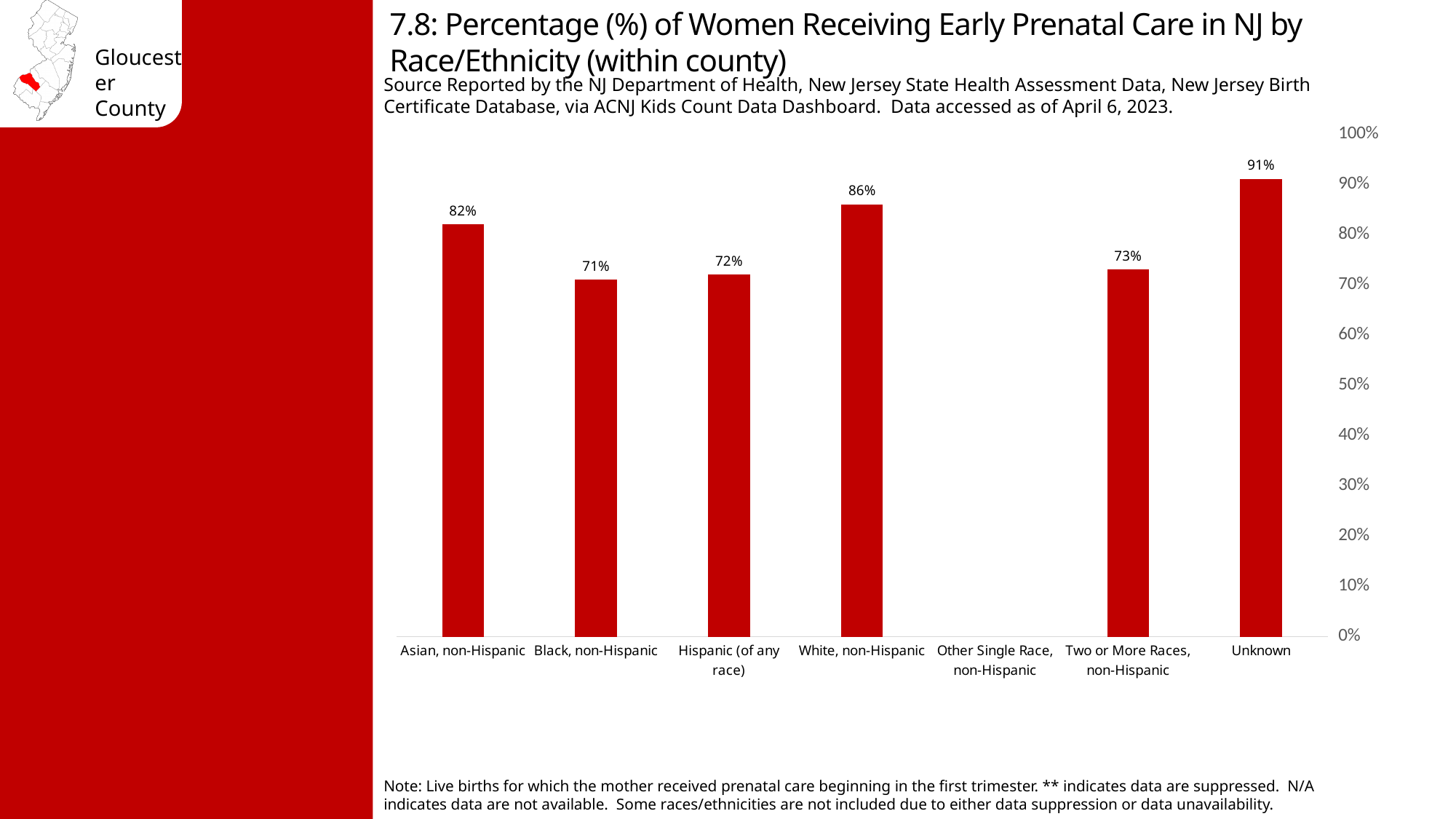
What is the difference between the values for White, non-Hispanic and Hispanic (of any race)? 14% Which category has the lowest percentage? Black, non-Hispanic Which is larger, the value for Asian, non-Hispanic or the value for Two or More Races, non-Hispanic? Asian, non-Hispanic What percentage of Asian, non-Hispanic women received early prenatal care? 82% What is the value shown for Two or More Races, non-Hispanic? 73% What is the value shown for Black, non-Hispanic? 71% Which category on the x axis has no bar plotted? Other Single Race, non-Hispanic Is the value for Unknown greater or less than 90%? greater Which category has the highest percentage? Unknown What kind of chart is shown on the slide? Bar chart How many categories are labeled on the x axis? 7 What is the value shown for White, non-Hispanic? 86%